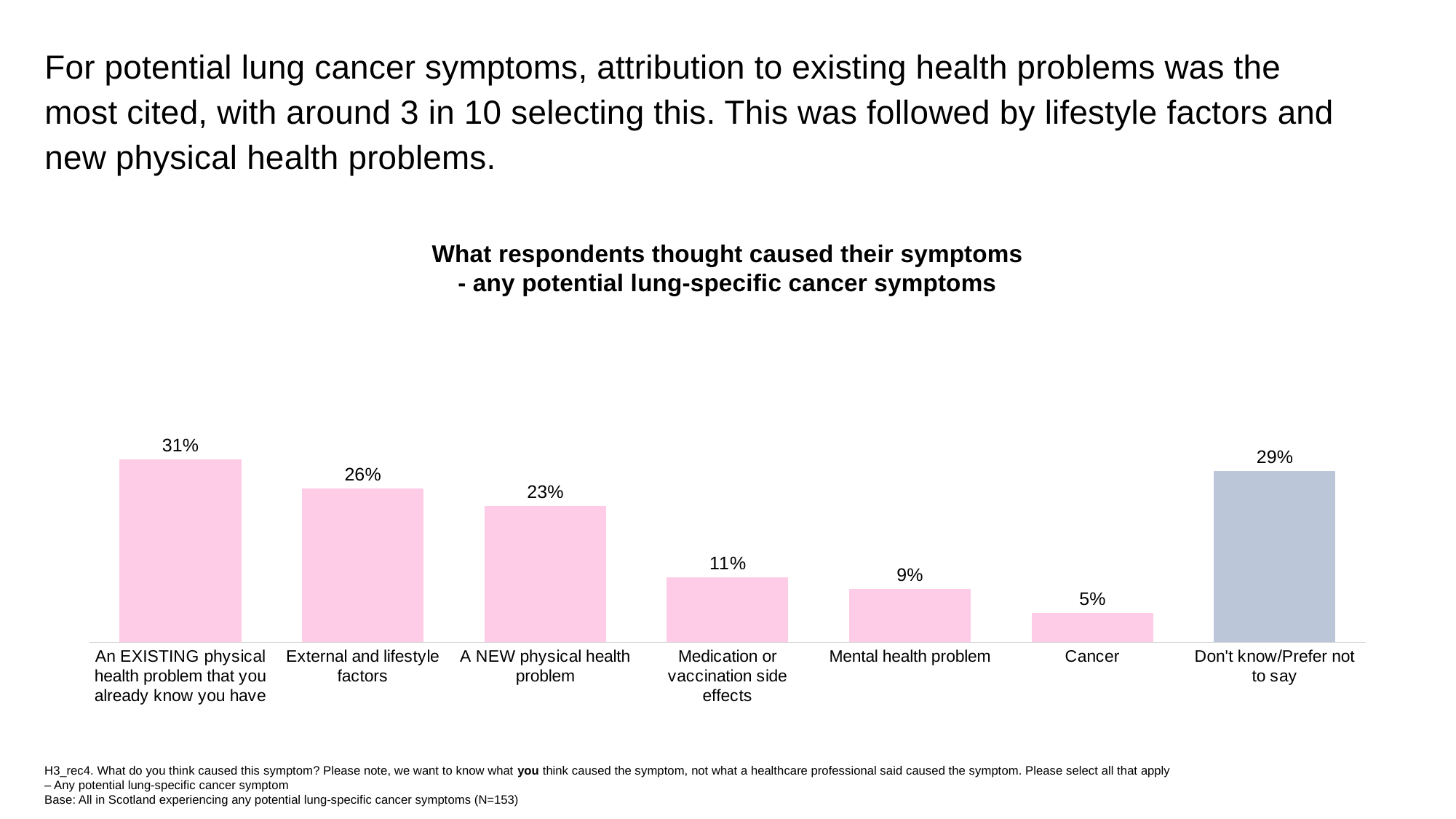
What value is shown for Don't know/Prefer not to say? 29% Which category has the lowest value? Cancer What percentage of respondents attributed their symptoms to an existing physical health problem that they already know they have? 31% Which category has the highest value? An EXISTING physical health problem that you already know you have Which is larger: the value for External and lifestyle factors or the value for Don't know/Prefer not to say? Don't know/Prefer not to say What percentage is shown for Medication or vaccination side effects? 11% What is the difference between the values for A NEW physical health problem and Mental health problem? 14 percentage points What is the title of the chart? What respondents thought caused their symptoms - any potential lung-specific cancer symptoms How many categories are shown in the chart? 7 What kind of chart is shown on the slide? Bar chart Which bar is shown in a different colour (grey-blue) from the others? Don't know/Prefer not to say What value is shown for External and lifestyle factors? 26%